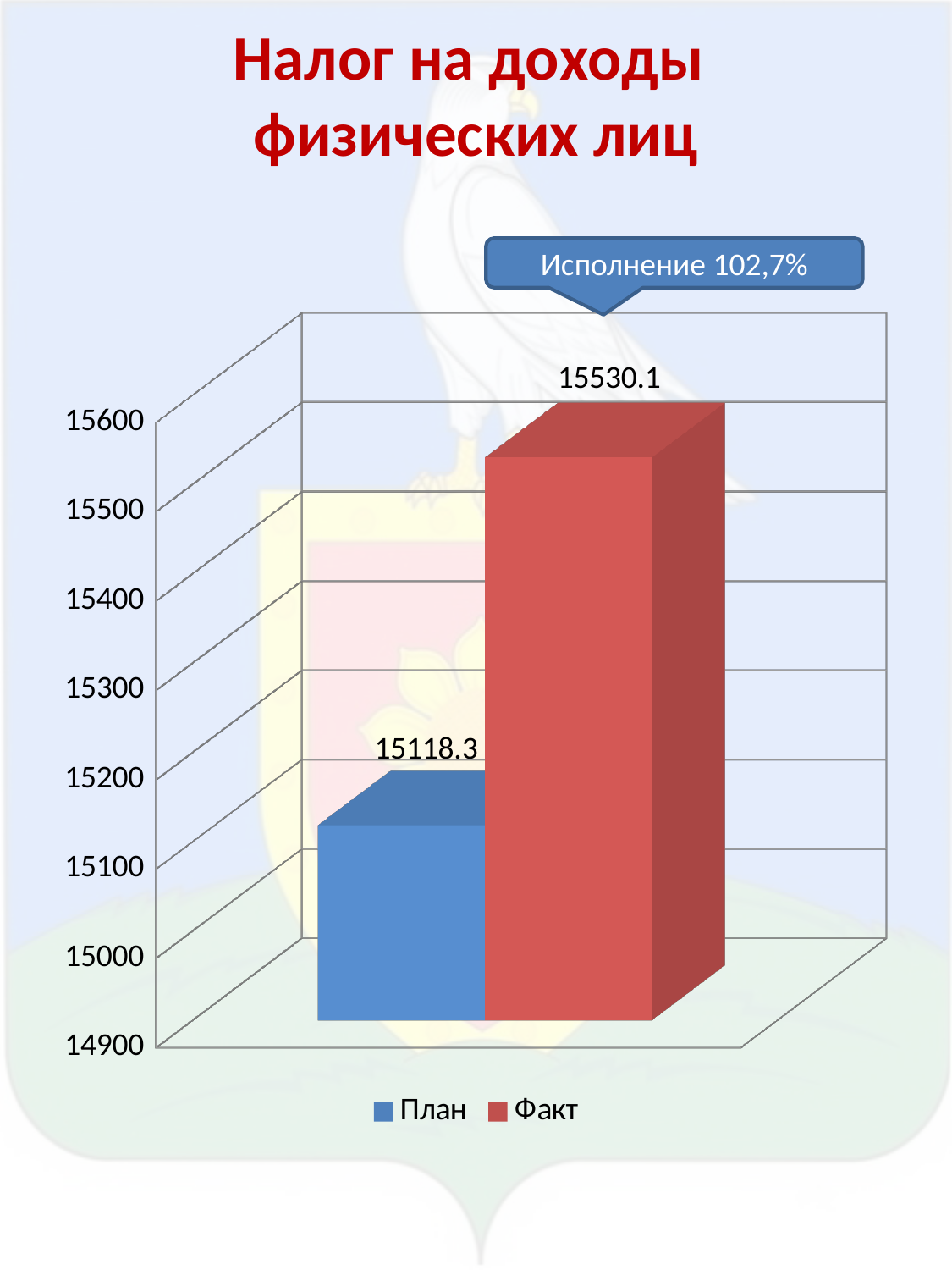
Which series has the higher value, План or Факт? Факт Which bar is the highest on the chart? Факт What execution percentage is shown in the callout above the chart? 102,7% Which bar is the lowest on the chart? План What kind of chart is shown on the slide? Bar chart What is the value for План (Plan)? 15118.3 Is the value for Факт greater or less than 15500? greater Is the value for План greater or less than 15200? less What is the title of the slide? Налог на доходы физических лиц What is the value for Факт (Actual)? 15530.1 How many series does the legend list? 2 What is the difference between the Факт value and the План value? 411.8